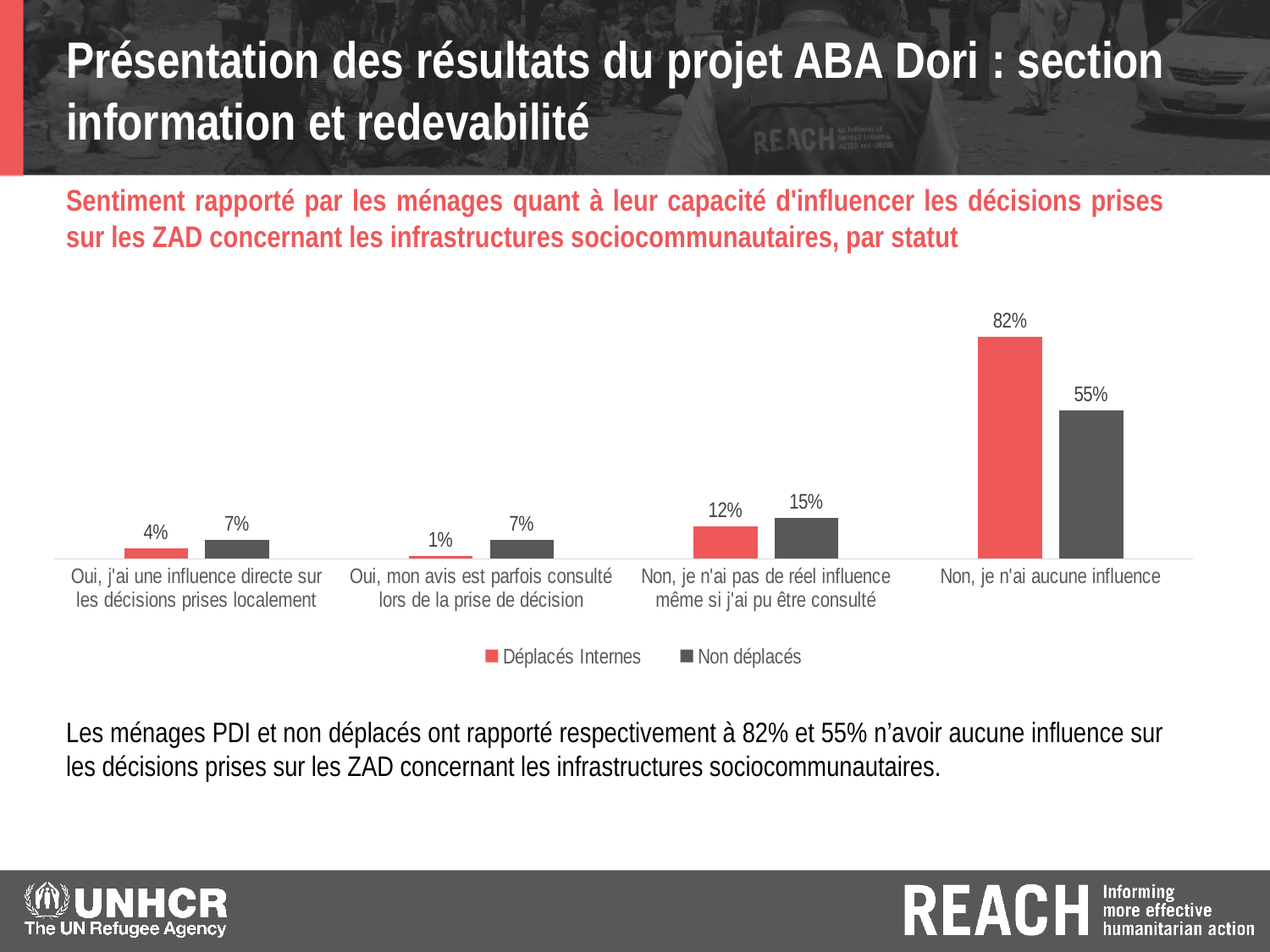
What percentage of Non déplacés households reported "Non, je n'ai aucune influence"? 55% Which series is shown in red in the legend? Déplacés Internes How many series does the legend list? 2 For "Oui, j'ai une influence directe sur les décisions prises localement", which series has the larger value, Déplacés Internes or Non déplacés? Non déplacés What type of chart is shown on the slide? Bar chart What percentage of Déplacés Internes households reported "Non, je n'ai aucune influence"? 82% Which category has the lowest value for Déplacés Internes? Oui, mon avis est parfois consulté lors de la prise de décision How many response categories are shown on the x axis? 4 Which category has the highest value for Déplacés Internes? Non, je n'ai aucune influence What is the value for Non déplacés in the category "Non, je n'ai pas de réel influence même si j'ai pu être consulté"? 15% What is the value for Déplacés Internes in the category "Oui, mon avis est parfois consulté lors de la prise de décision"? 1% What is the difference between the Déplacés Internes and Non déplacés values for "Non, je n'ai aucune influence"? 27%